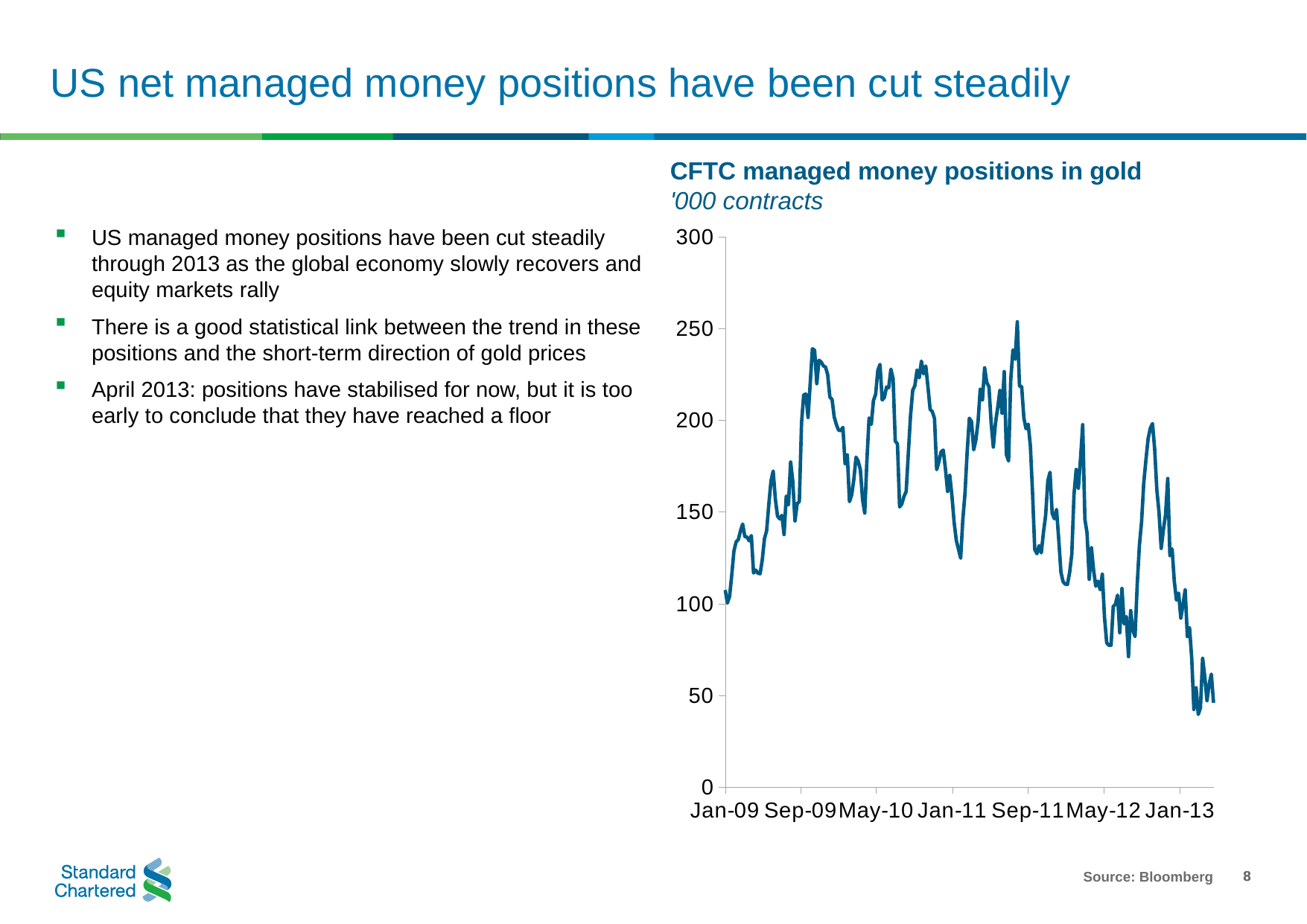
In what units are the values on the chart expressed? '000 contracts What kind of chart is shown on the slide? Line chart Does the line generally rise or fall between Sep-11 and the end of the series? Fall Is the value around May-10 greater or less than 150? greater How many date labels are shown on the x axis of the chart? 7 Is the peak value of the line greater or less than 200? greater Does the line generally rise or fall between Jan-09 and Sep-09? Rise What is the highest value shown on the y axis of the chart? 300 What is the title of the chart? CFTC managed money positions in gold Is the value around Sep-09 greater or less than 100? greater